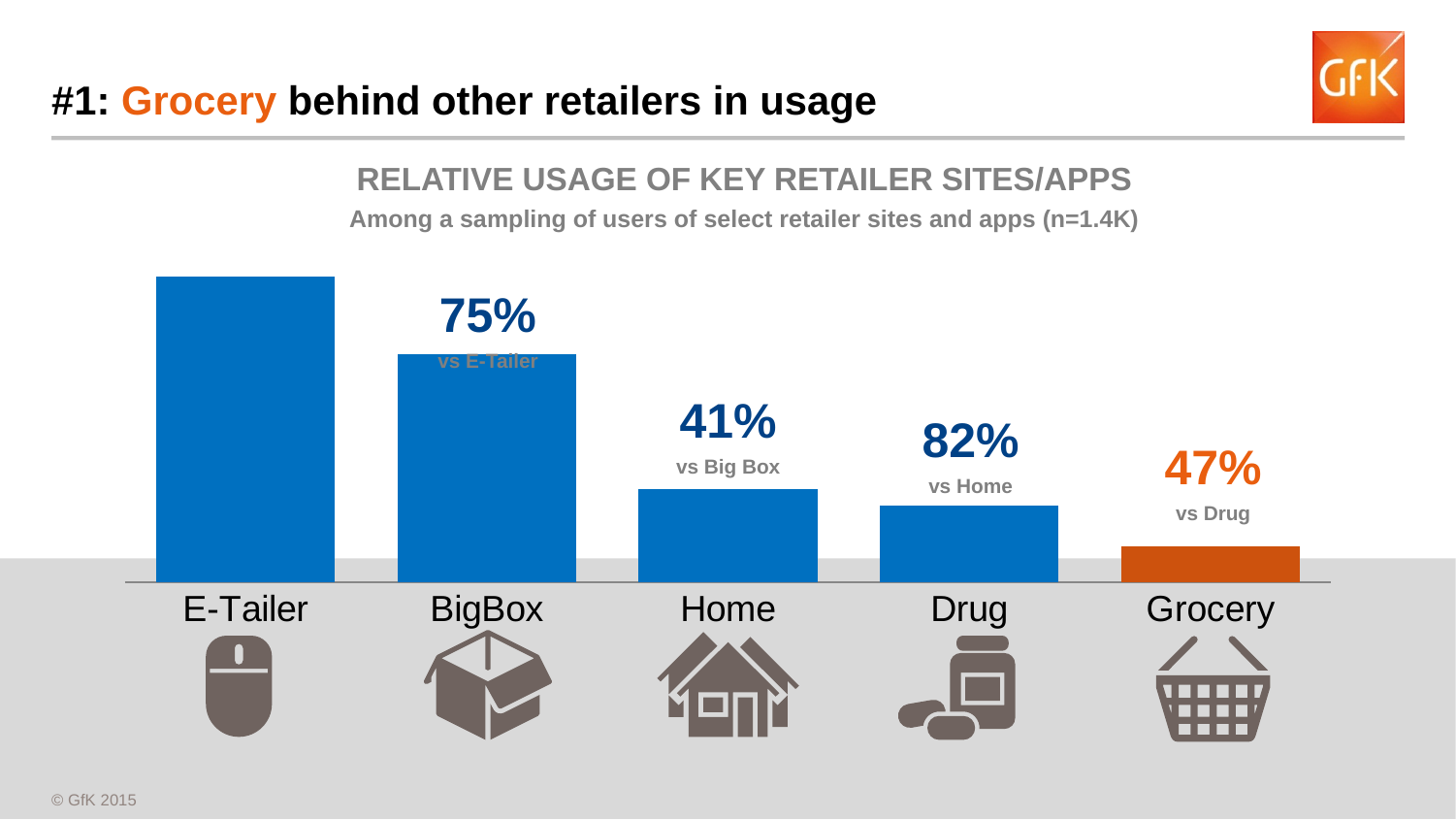
What percentage is printed above the Grocery bar? 47% How many retailer categories are shown in the chart? 5 Do the bar heights rise or fall from left to right across the chart? fall Which retailer category has the tallest bar? E-Tailer Which retailer category has the shortest bar? Grocery Which bar is taller, E-Tailer or BigBox? E-Tailer Which retailer category's bar is coloured orange instead of blue? Grocery What kind of chart is shown on the slide? bar chart What percentage is printed above the BigBox bar? 75% What percentage is printed above the Home bar? 41% What percentage is printed above the Drug bar? 82% Which bar is taller, Drug or Grocery? Drug